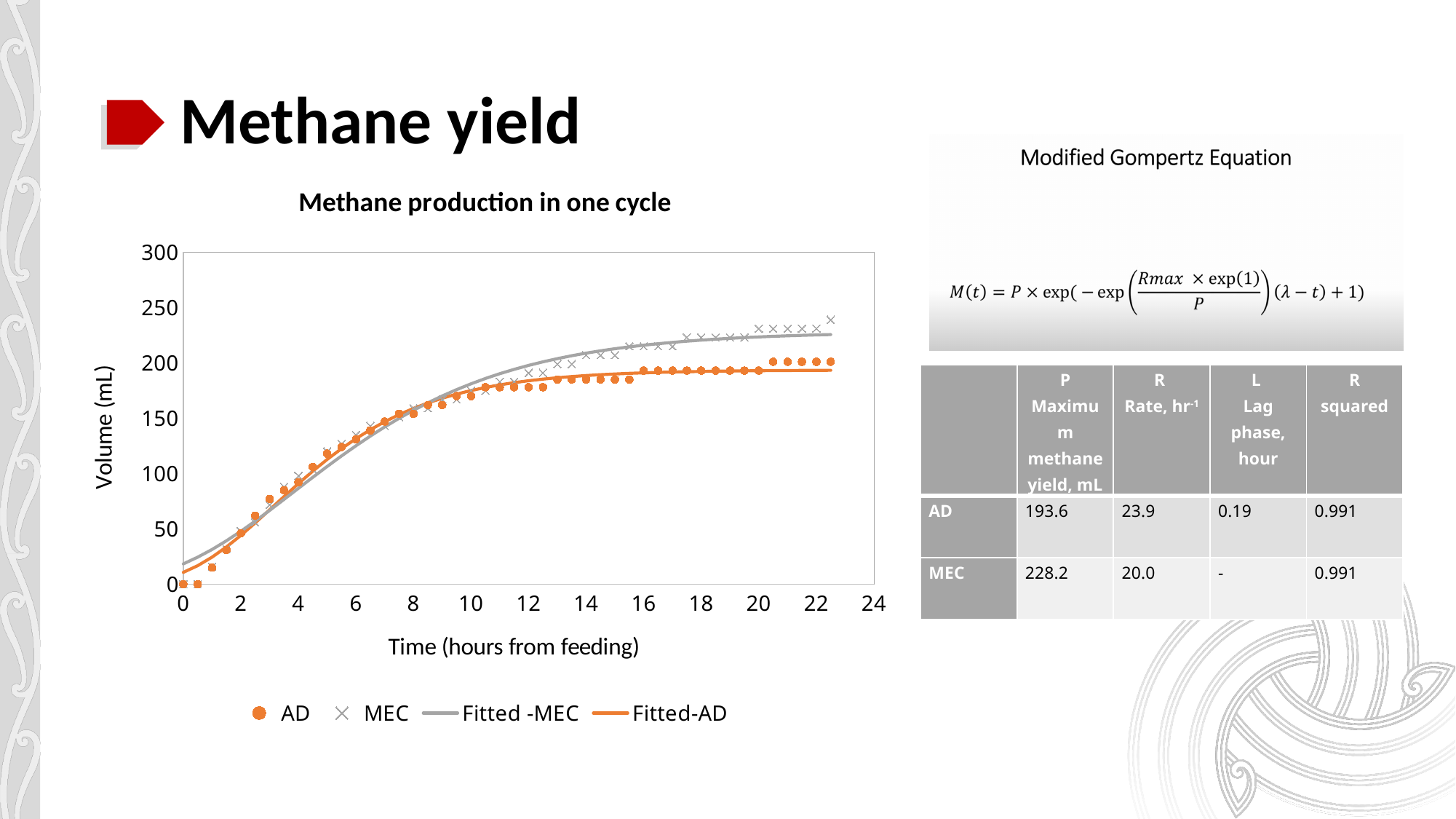
Is the value for MEC at 22 hours greater or less than 200? greater What kind of chart is shown on the slide? Scatter chart with fitted lines Is the value for AD at 20 hours greater or less than 150? greater What is the title of the chart on the slide? Methane production in one cycle At 22 hours, which series has the larger volume, AD or MEC? MEC How many series does the chart legend list? 4 What is the maximum value shown on the y axis of the chart? 300 Do the methane volumes rise or fall as time increases along the x axis? Rise Is the value for MEC at 2 hours greater or less than 100? less Which measured series reaches the highest volume by the end of the cycle? MEC What is the label of the x axis of the chart? Time (hours from feeding)